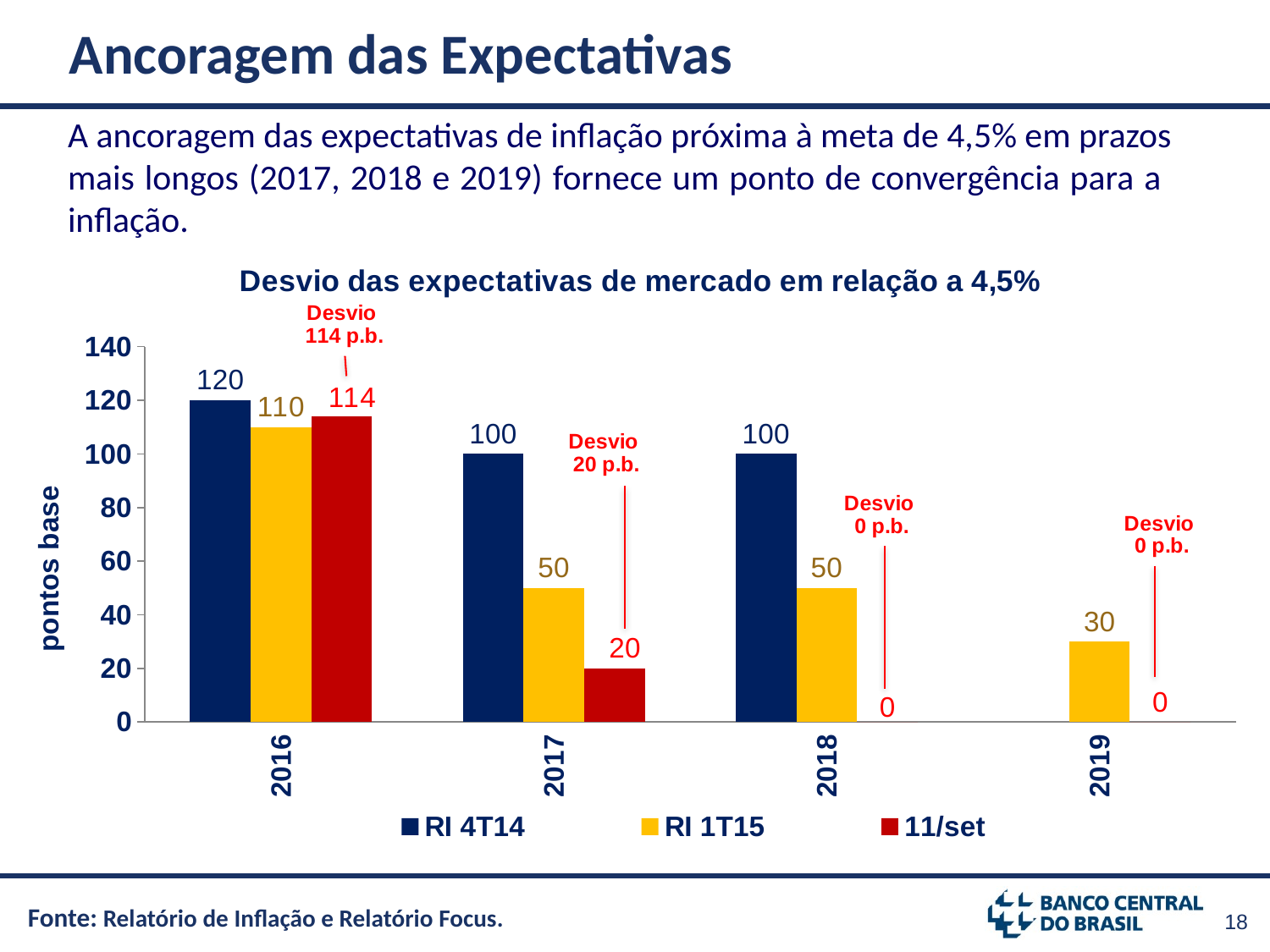
What is the value for 11/set in 2018? 0 How many series does the legend list? 3 What is the value for 11/set in 2017? 20 What is the value for RI 4T14 in 2016? 120 What is the value for RI 1T15 in 2019? 30 What is the difference between the RI 4T14 and RI 1T15 values in 2017? 50 Which is larger in 2016: the RI 1T15 value or the 11/set value? 11/set Which year has the lowest value for the RI 1T15 series? 2019 What is the label of the y axis? pontos base What kind of chart is shown on the slide? Bar chart How many years are shown on the x axis? 4 Which year has the highest value for the 11/set series? 2016